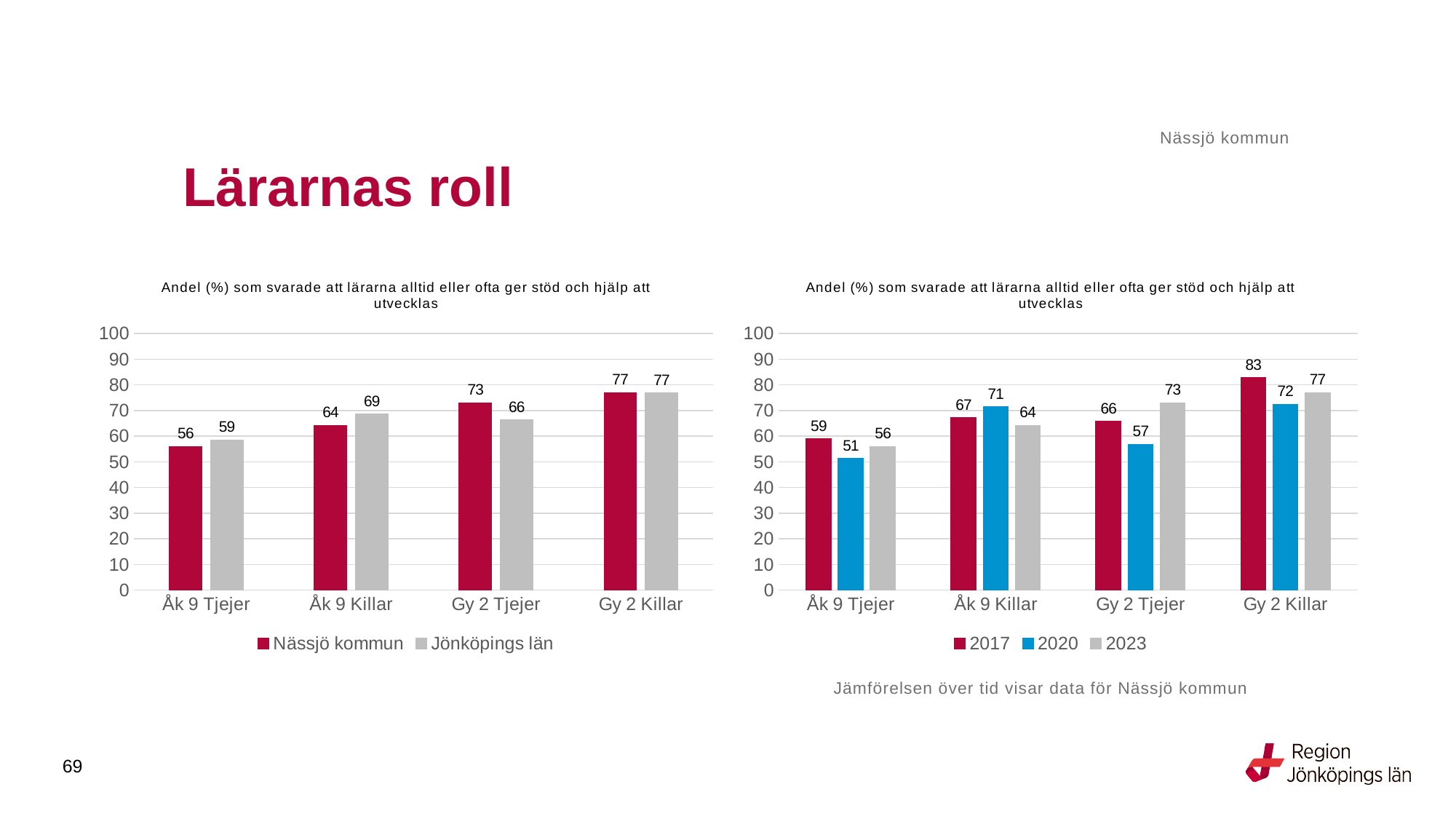
In the right chart, what is the difference between the 2017 and 2023 values for Gy 2 Killar? 6 In the right chart, how many series does the legend list? 3 In the left chart, what is the difference between Nässjö kommun and Jönköpings län for Gy 2 Tjejer? 7 In the left chart, what is the value for Jönköpings län for Åk 9 Killar? 69 In the right chart, which category has the lowest value for 2020? Åk 9 Tjejer What kind of chart is the left chart? Bar chart In the left chart, what is the value for Nässjö kommun for Åk 9 Tjejer? 56 In the right chart, is the value for 2017 or 2023 larger for Gy 2 Tjejer? 2023 In the right chart, what is the value for 2017 for Gy 2 Killar? 83 In the left chart, how many series does the legend list? 2 In the right chart, what is the value for 2020 for Åk 9 Tjejer? 51 In the left chart, which category has the highest value for Nässjö kommun? Gy 2 Killar